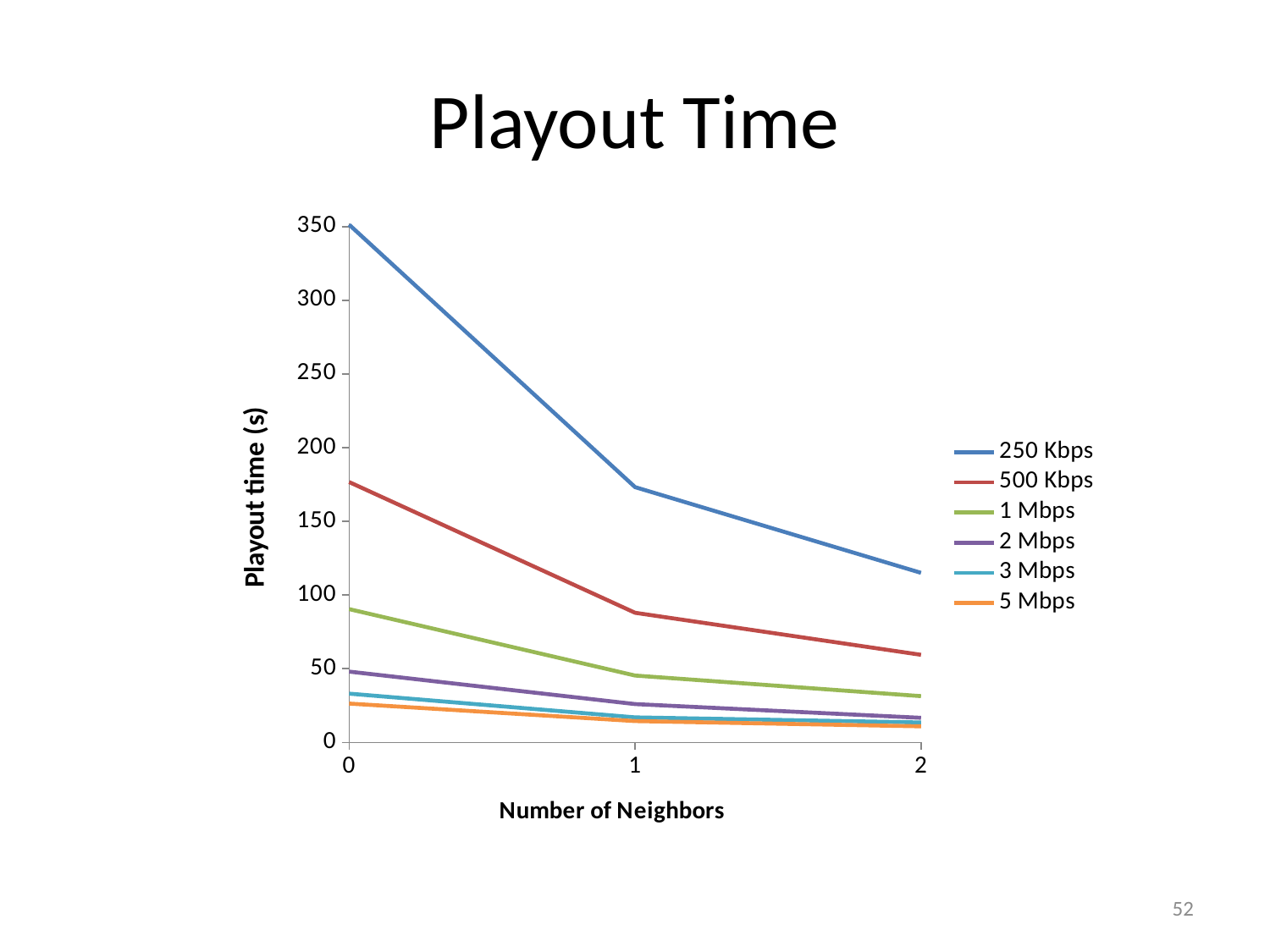
What is the title of the x axis? Number of Neighbors Is the playout time for 250 Kbps at 2 neighbors greater or less than 100? greater What kind of chart is shown on the slide? line chart At 2 neighbors, which has the larger playout time: 250 Kbps or 500 Kbps? 250 Kbps Does the playout time for 250 Kbps rise or fall as the number of neighbors increases? fall Is the playout time for 250 Kbps at 1 neighbor greater or less than 150? greater Which series has the highest playout time at 0 neighbors? 250 Kbps Is the playout time for 500 Kbps at 0 neighbors greater or less than 150? greater How many points along the x axis (Number of Neighbors) are plotted for each series? 3 How many series does the legend list? 6 Which series has the lowest playout time at 0 neighbors? 5 Mbps